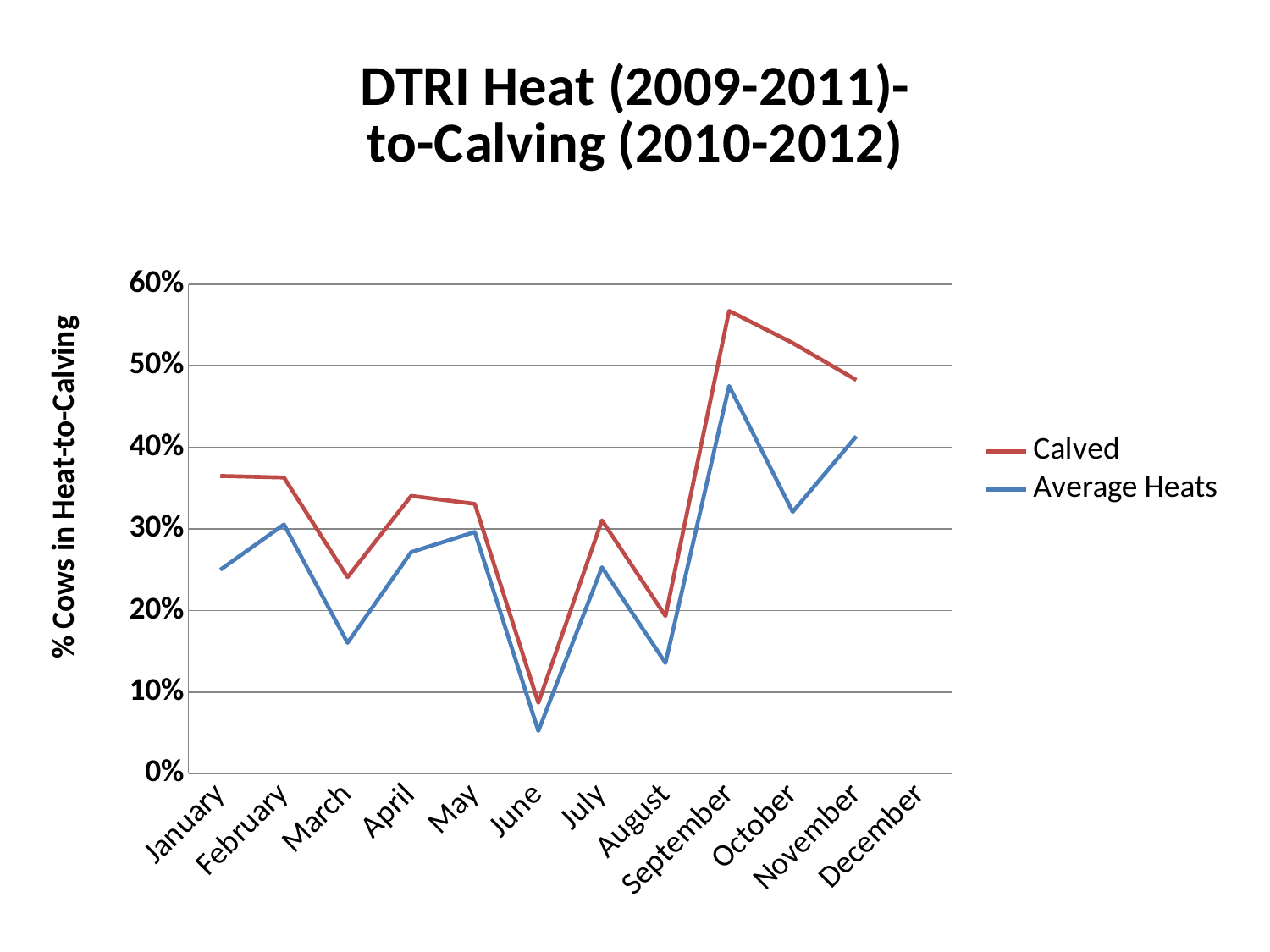
In September, which series has the higher value, Calved or Average Heats? Calved How many series does the legend list? 2 Does the Calved series rise or fall from September to November? fall Is the Calved value for January greater or less than 30%? greater What kind of chart is shown on the slide? line chart Is the Average Heats value for March greater or less than 20%? less How many months are labeled on the x axis? 12 In which month does the Average Heats series reach its lowest value? June In which month does the Calved series reach its highest value? September Is the Calved value for September greater or less than 50%? greater What is the label on the vertical axis? % Cows in Heat-to-Calving